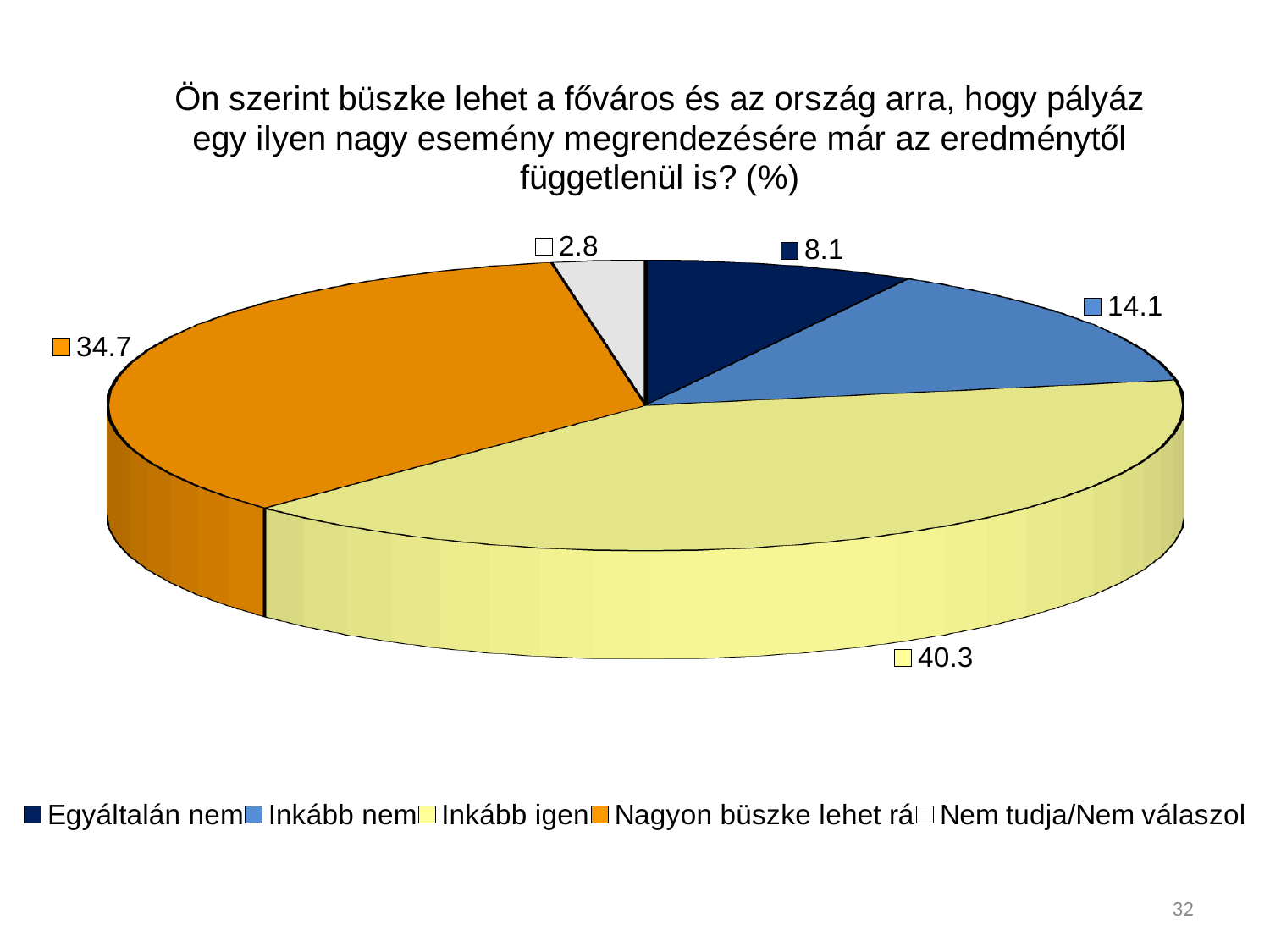
What is the value for "Egyáltalán nem"? 8.1 What is the value for "Nagyon büszke lehet rá"? 34.7 What is the value for "Inkább nem"? 14.1 What colour is the slice for "Nagyon büszke lehet rá"? Orange What kind of chart is shown on the slide? Pie chart What is the value for "Nem tudja/Nem válaszol"? 2.8 How many categories does the pie chart show? 5 What is the value for "Inkább igen"? 40.3 Which is larger, the value for "Inkább nem" or the value for "Egyáltalán nem"? Inkább nem What is the difference between the values for "Inkább igen" and "Nagyon büszke lehet rá"? 5.6 Which category has the largest slice? Inkább igen Which category has the smallest slice? Nem tudja/Nem válaszol